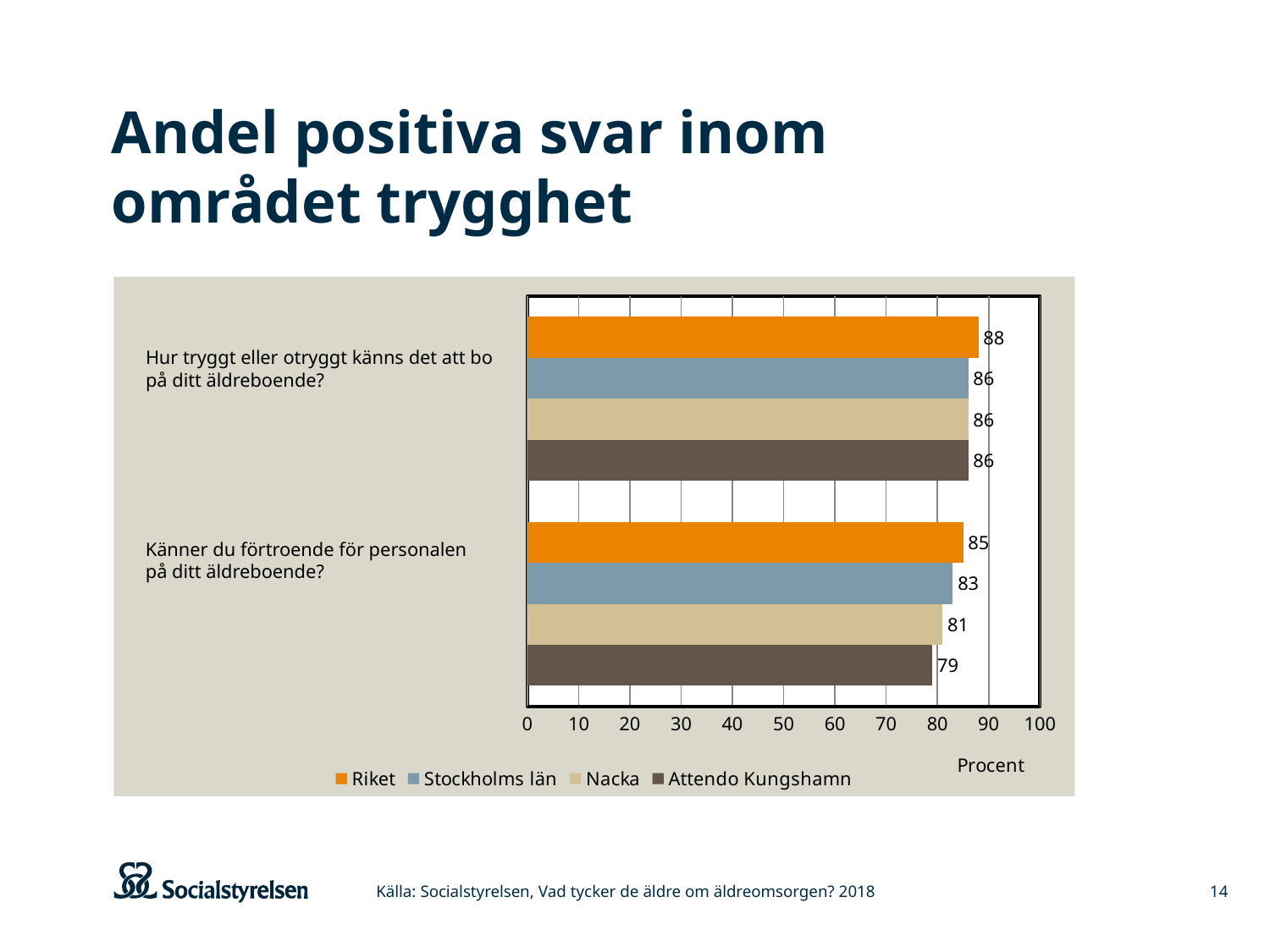
What kind of chart is shown on the slide? Bar chart Which series has the lowest value on the question "Känner du förtroende för personalen på ditt äldreboende?"? Attendo Kungshamn What is the label of the x axis? Procent What is the value for Nacka on the question "Känner du förtroende för personalen på ditt äldreboende?"? 81 Which series has the highest value on the question "Känner du förtroende för personalen på ditt äldreboende?"? Riket What is the value for Stockholms län on the question "Känner du förtroende för personalen på ditt äldreboende?"? 83 What is the difference between Riket and Attendo Kungshamn on the question "Känner du förtroende för personalen på ditt äldreboende?"? 6 What is the value for Attendo Kungshamn on the question "Känner du förtroende för personalen på ditt äldreboende?"? 79 How many series does the legend list? 4 Is the value for Attendo Kungshamn on "Känner du förtroende för personalen på ditt äldreboende?" greater or less than 80? less Which is larger for Attendo Kungshamn: the value for "Hur tryggt eller otryggt känns det att bo på ditt äldreboende?" or the value for "Känner du förtroende för personalen på ditt äldreboende?"? Hur tryggt eller otryggt känns det att bo på ditt äldreboende? What is the value for Riket on the question "Hur tryggt eller otryggt känns det att bo på ditt äldreboende?"? 88